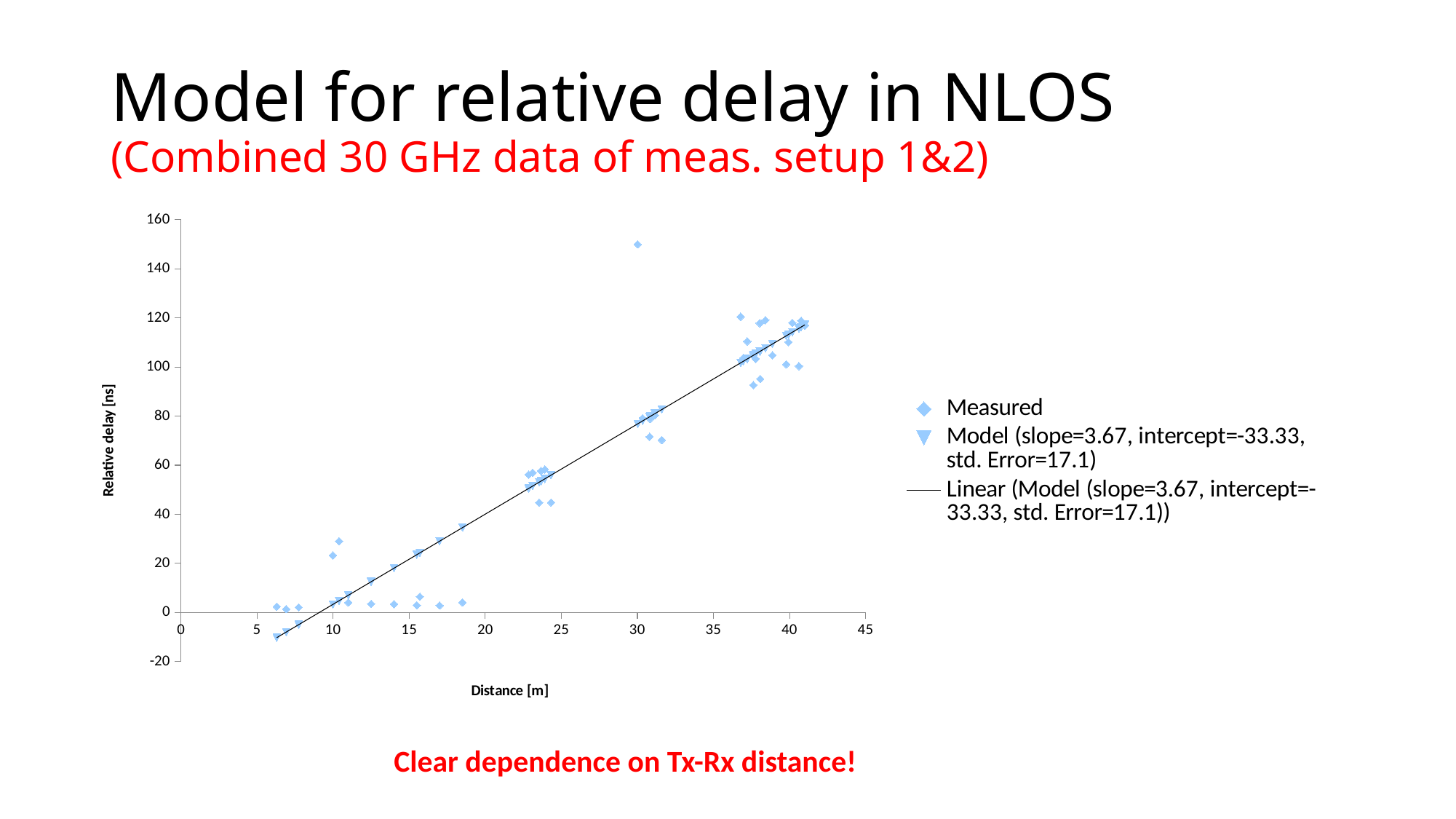
Are the measured relative delay values at about 10 m greater or less than 40? less What intercept does the legend give for the model? -33.33 Are the measured relative delay values at about 40 m greater or less than 80? greater What kind of chart is shown on the slide? scatter chart Do the measured relative delay values rise or fall as distance increases along the x axis? rise Which has larger measured relative delay values: the points at about 40 m or the points at about 10 m? the points at about 40 m Are the measured relative delay values at about 15 m greater or less than 40? less How many series does the legend list? 3 What slope does the legend give for the model? 3.67